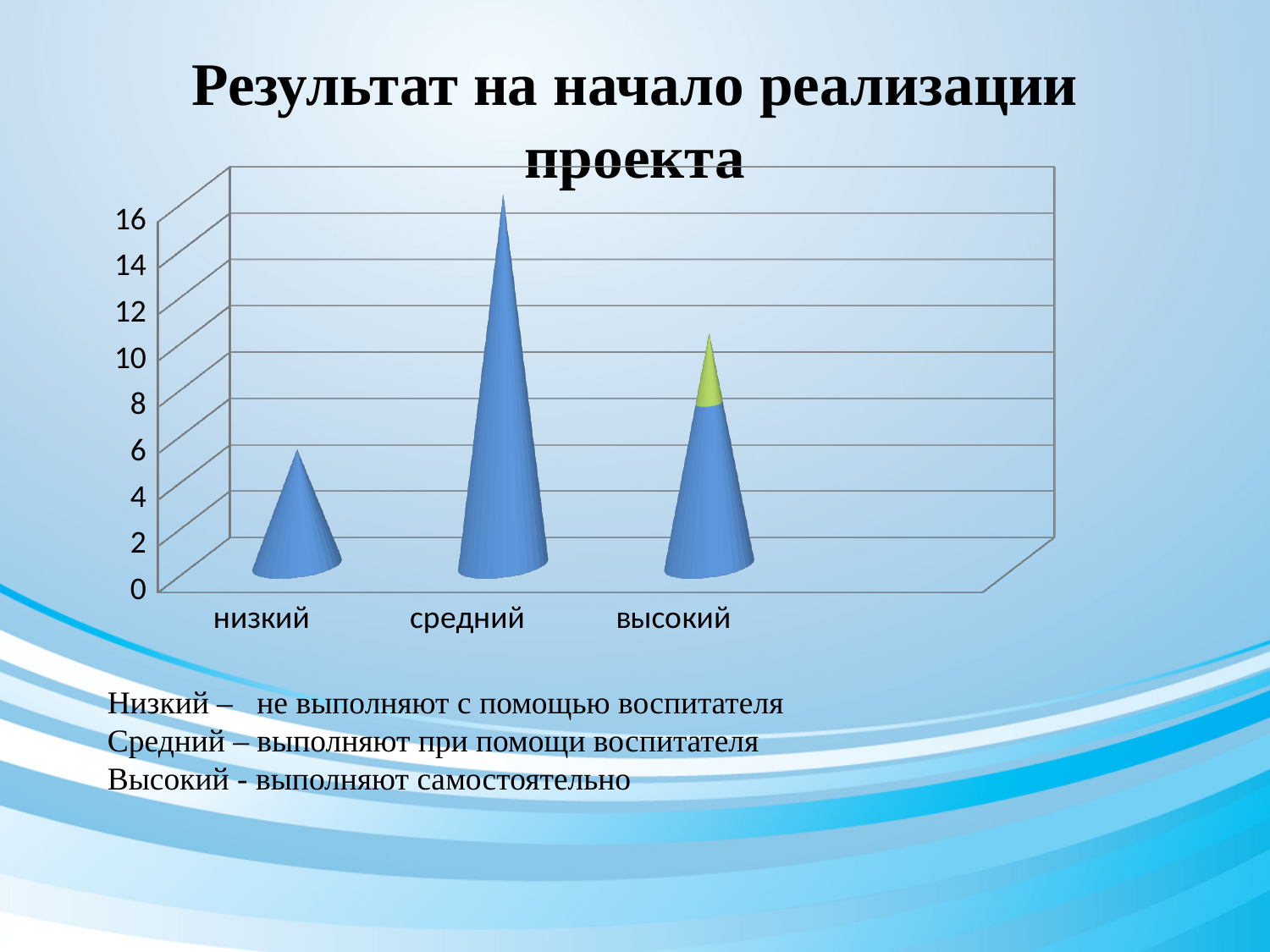
What is the title of the chart? Результат на начало реализации проекта Which is larger, the value for низкий or the value for высокий? высокий What kind of chart is shown on the slide? bar chart Which category has the lowest value? низкий Is the value for высокий greater or less than 14? less Which category has the highest value? средний How many categories are shown on the x axis of the chart? 3 What is the highest tick value shown on the vertical axis? 16 Is the value for высокий greater or less than 8? greater Is the value for средний greater or less than 14? greater Which is larger, the value for средний or the value for высокий? средний